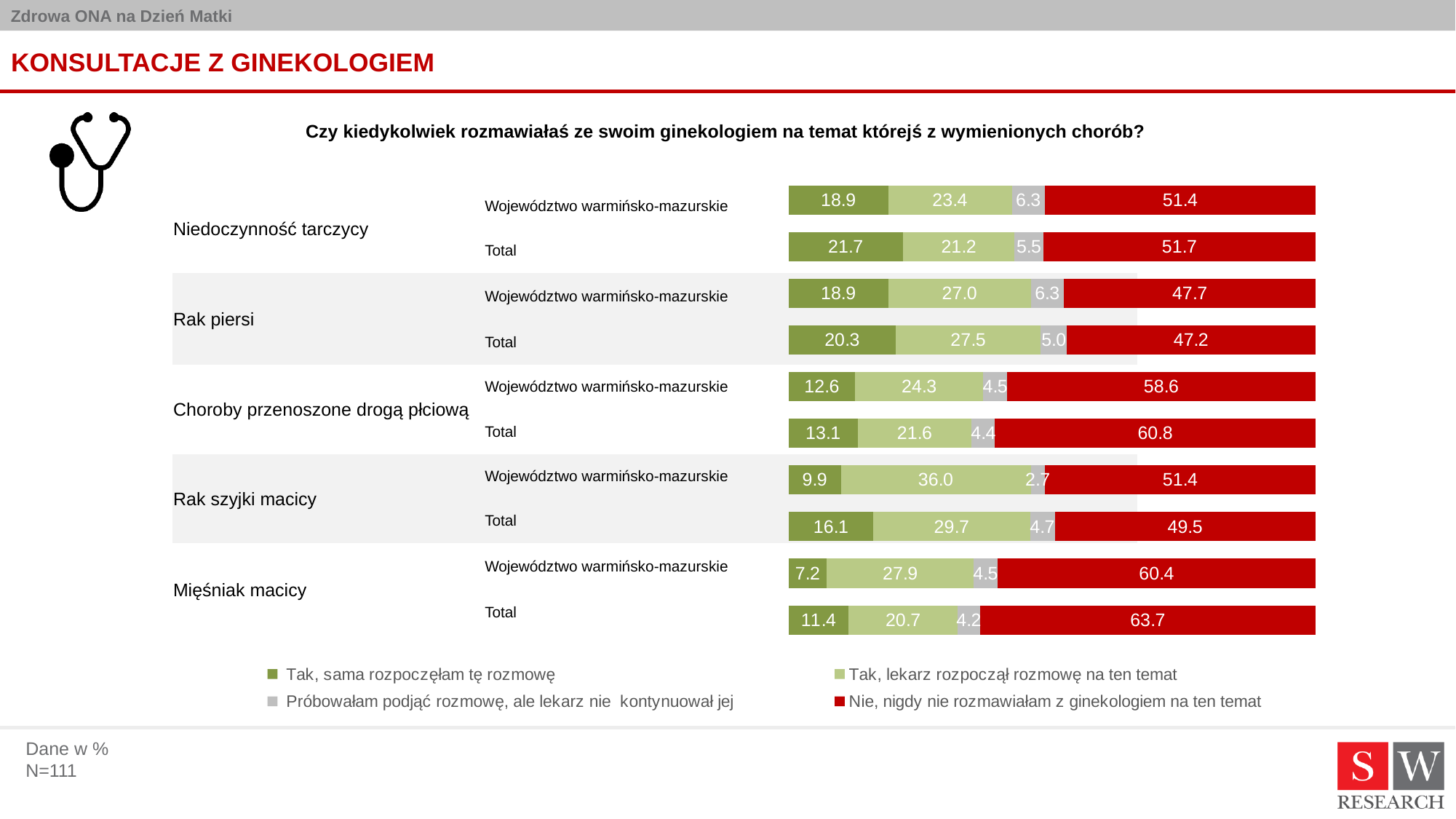
What kind of chart is shown on the slide? Stacked bar chart What is the value for "Próbowałam podjąć rozmowę, ale lekarz nie kontynuował jej" in the Total bar for Rak piersi? 5.0 For Niedoczynność tarczycy, which is larger for "Tak, sama rozpoczęłam tę rozmowę": Województwo warmińsko-mazurskie or Total? Total For Choroby przenoszone drogą płciową, what is the difference between the Total and Województwo warmińsko-mazurskie values for "Nie, nigdy nie rozmawiałam z ginekologiem na ten temat"? 2.2 How many bars are plotted in the chart? 10 What is the value for "Tak, sama rozpoczęłam tę rozmowę" in the Województwo warmińsko-mazurskie bar for Rak szyjki macicy? 9.9 How many series does the legend list? 4 Which colour represents "Nie, nigdy nie rozmawiałam z ginekologiem na ten temat" in the legend? Red Which bar has the lowest value for "Tak, sama rozpoczęłam tę rozmowę"? Mięśniak macicy, Województwo warmińsko-mazurskie (7.2) What is the total of the Województwo warmińsko-mazurskie bar for Niedoczynność tarczycy? 100.0 What is the value for "Nie, nigdy nie rozmawiałam z ginekologiem na ten temat" in the Total bar for Mięśniak macicy? 63.7 Which bar has the highest value for "Tak, lekarz rozpoczął rozmowę na ten temat"? Rak szyjki macicy, Województwo warmińsko-mazurskie (36.0)